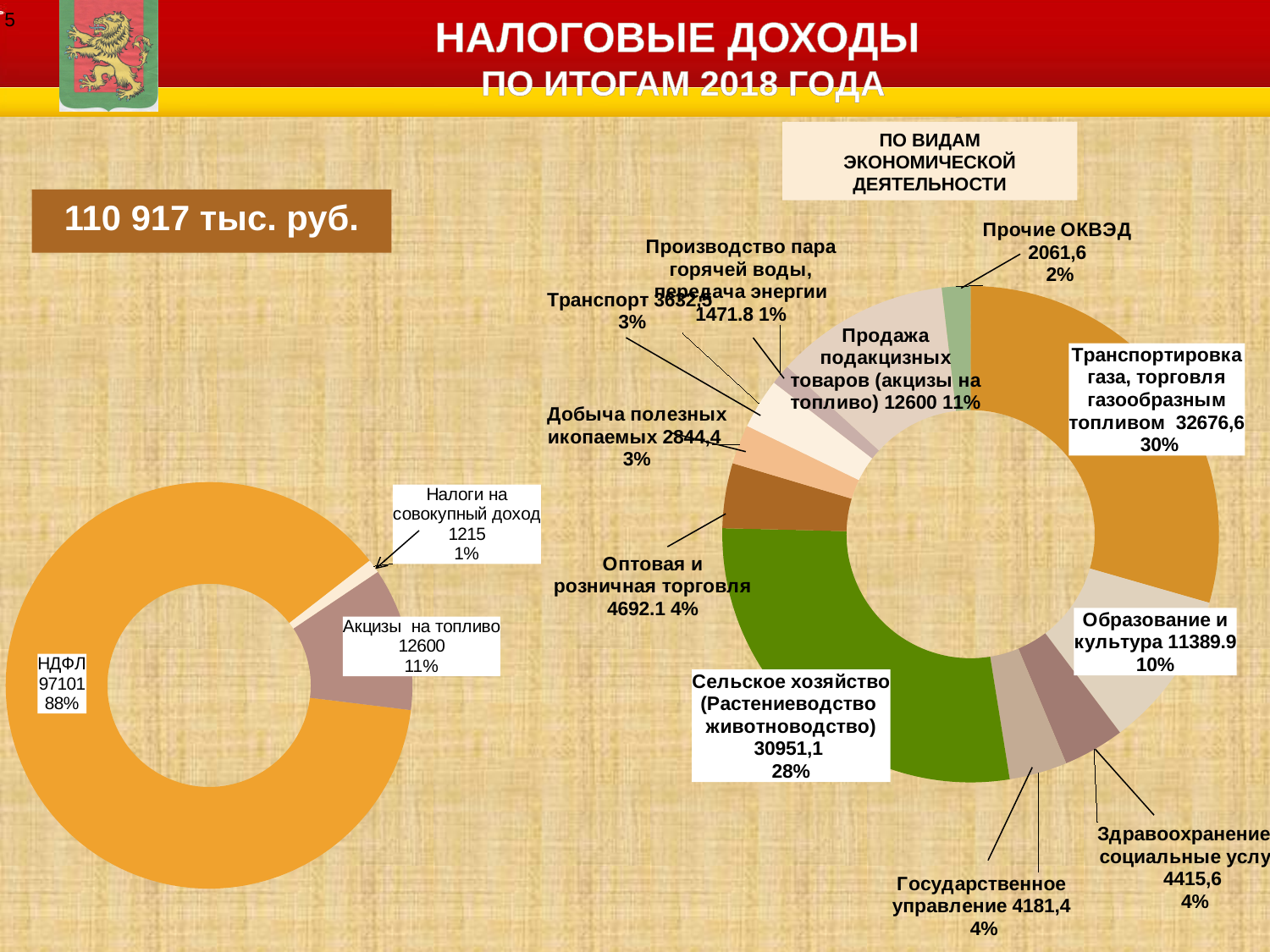
On the left doughnut chart, what is the difference between НДФЛ and Акцизы на топливо? 84501 On the left doughnut chart, which category is the smallest? Налоги на совокупный доход On the left doughnut chart, what share does Акцизы на топливо have? 11% On the chart titled ПО ВИДАМ ЭКОНОМИЧЕСКОЙ ДЕЯТЕЛЬНОСТИ, which is larger: Здравоохранение и социальные услуги or Государственное управление? Здравоохранение и социальные услуги How many categories does the chart titled ПО ВИДАМ ЭКОНОМИЧЕСКОЙ ДЕЯТЕЛЬНОСТИ show? 11 On the chart titled ПО ВИДАМ ЭКОНОМИЧЕСКОЙ ДЕЯТЕЛЬНОСТИ, which category has the largest share? Транспортировка газа, торговля газообразным топливом On the chart titled ПО ВИДАМ ЭКОНОМИЧЕСКОЙ ДЕЯТЕЛЬНОСТИ, which category has the smallest share? Производство пара горячей воды, передача энергии On the left doughnut chart, what value is shown for НДФЛ? 97101 On the chart titled ПО ВИДАМ ЭКОНОМИЧЕСКОЙ ДЕЯТЕЛЬНОСТИ, what share does Сельское хозяйство have? 28% What type of chart is used on the right side of the slide? Doughnut chart On the chart titled ПО ВИДАМ ЭКОНОМИЧЕСКОЙ ДЕЯТЕЛЬНОСТИ, what value is shown for Образование и культура? 11389.9 How many categories does the left doughnut chart show? 3